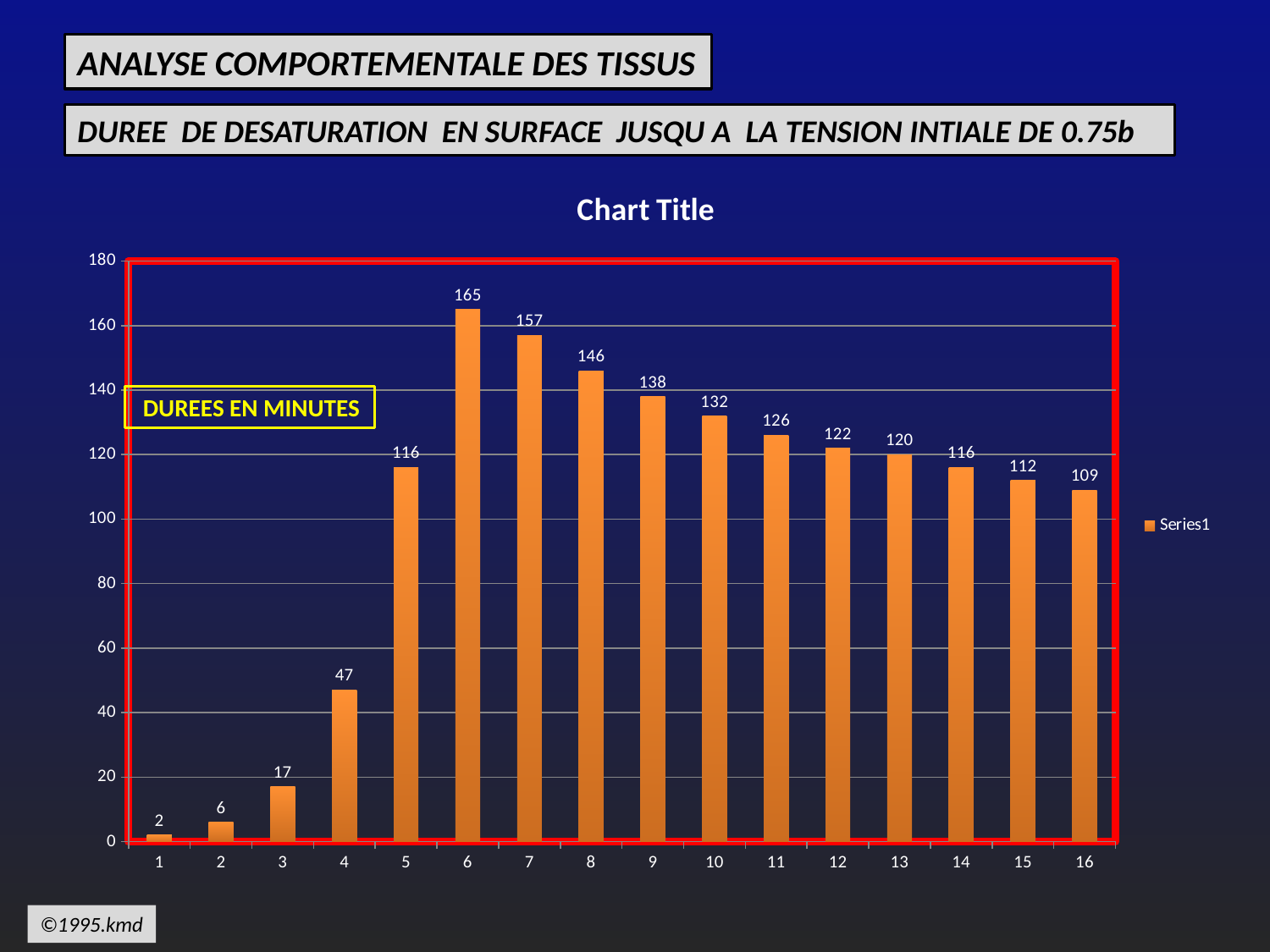
What is the value for category 4? 47 What kind of chart is shown? bar chart Do the values rise or fall from category 6 to category 16? fall Which category has the lowest value? 1 What is the difference between the values for category 6 and category 7? 8 How many categories are shown on the x axis? 16 How many series does the legend list? 1 What is the value for category 6? 165 Which category has the highest value? 6 Which is larger, the value for category 5 or the value for category 9? category 9 What is the value for category 16? 109 Is the value for category 8 greater or less than 140? greater